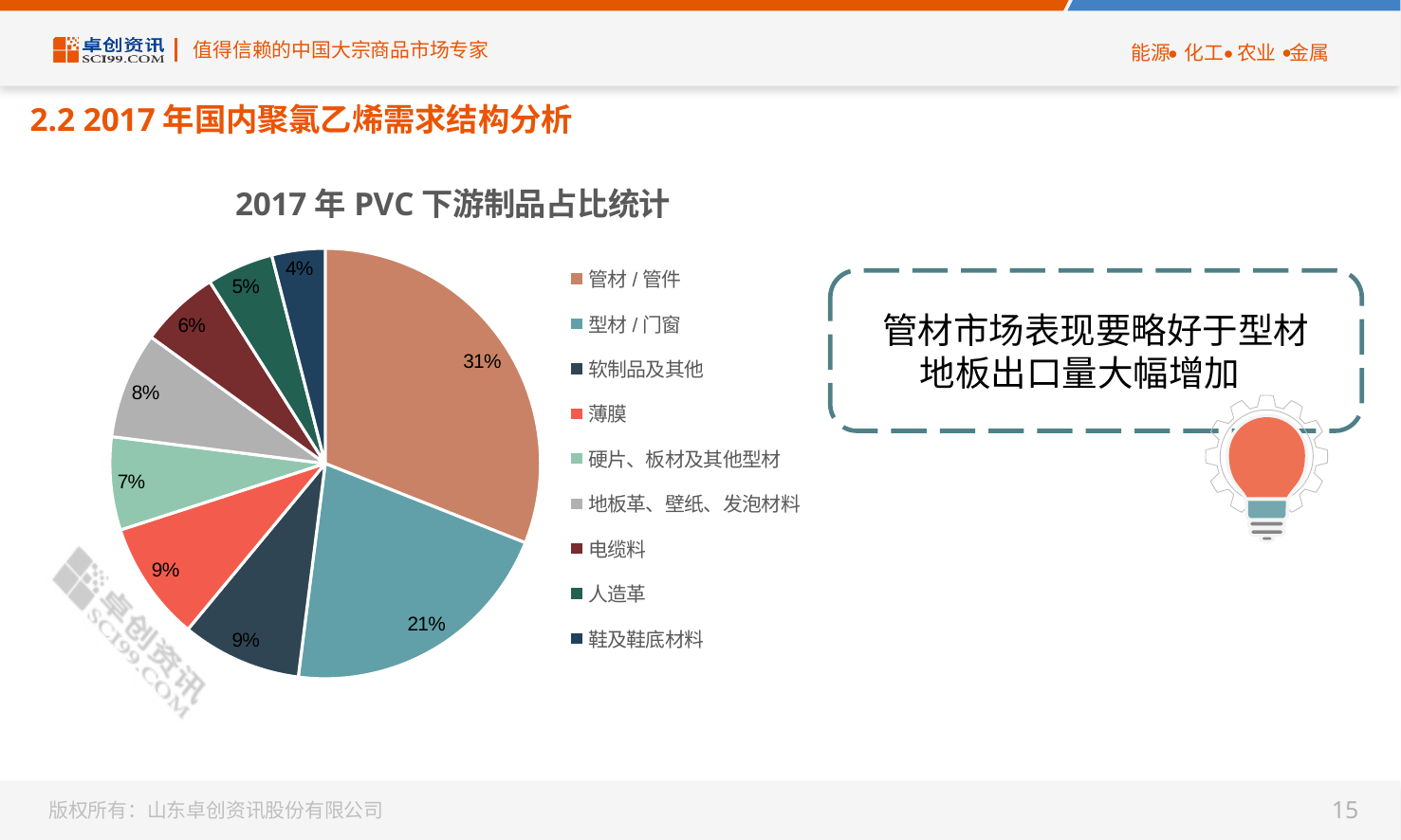
How many categories does the pie chart show? 9 What share of the pie does 型材/门窗 account for? 21% Which category has the smallest share of the pie? 鞋及鞋底材料 Which is larger, the share for 电缆料 or the share for 人造革? 电缆料 What is the combined share of 管材/管件 and 型材/门窗? 52% What share of the pie does 管材/管件 account for? 31% What is the difference in percentage points between 管材/管件 and 型材/门窗? 10 What is the title of the chart? 2017年PVC下游制品占比统计 Which category has the largest share of the pie? 管材/管件 What is the value shown for 地板革、壁纸、发泡材料? 8% What kind of chart is shown on the slide? Pie chart What is the value shown for 鞋及鞋底材料? 4%